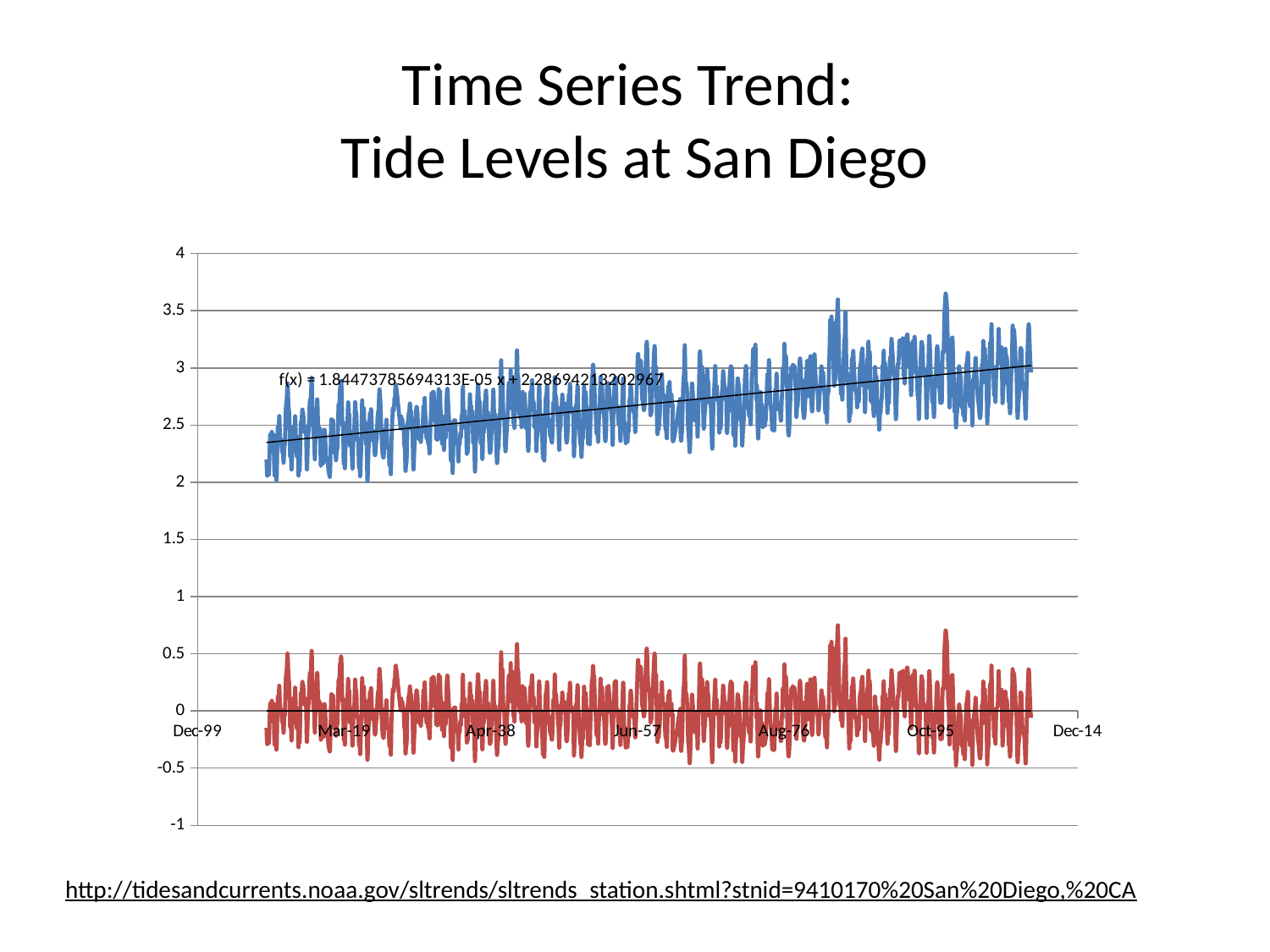
What kind of chart is shown on the slide? line chart Are the values of the blue series greater or less than 1.5 throughout the chart? greater Does the blue series generally rise or fall from left to right along the x axis? rise Is the highest value of the blue series greater or less than 4? less What is the title of the chart on the slide? Time Series Trend: Tide Levels at San Diego What is the trendline equation printed on the chart? f(x) = 1.84473785694313E-05 x + 2.28694213202967 Are the values of the red series greater or less than 1 throughout the chart? less Which series has higher values overall, the blue series or the red series? the blue series How many date labels are shown on the x axis? 7 What is the maximum value shown on the y axis? 4 What is the first date label on the x axis? Dec-99